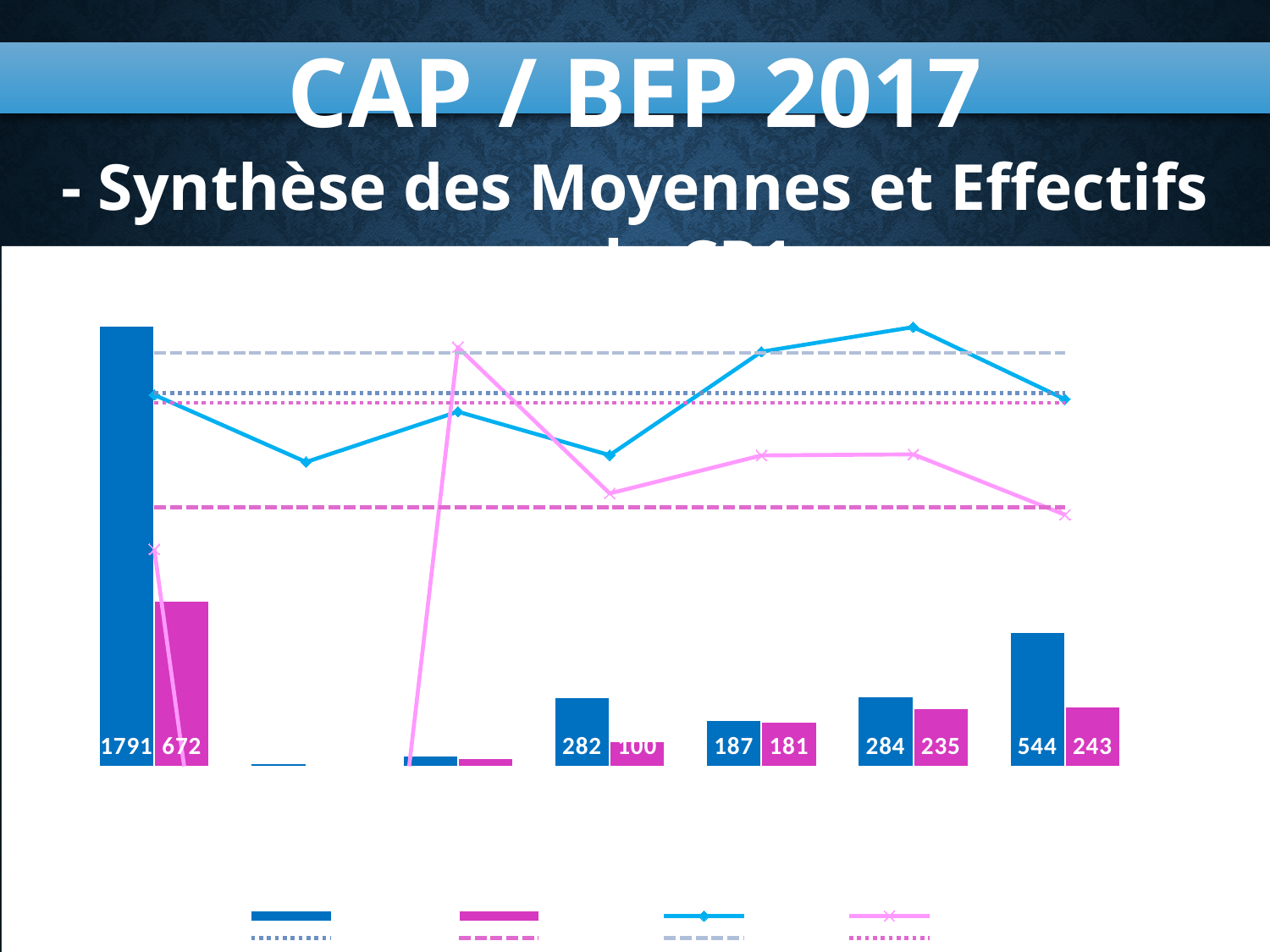
In the group with bars labelled 187 and 181, which bar is larger, the blue or the magenta one? The blue bar (187) What is the difference between the blue bar labelled 284 and the magenta bar labelled 235 in the same group? 49 What is the difference between the blue bar (544) and the magenta bar (243) in the rightmost group? 301 Which group of bars has the tallest blue bar? The leftmost group (1791) What is the value of the blue bar in the rightmost group of bars? 544 How many groups of bars are plotted along the x axis? 7 How many lines with markers are plotted on the chart (excluding the dashed reference lines)? 2 What kind of chart is shown on the slide? A combined bar and line chart What is the value of the magenta bar in the leftmost group of bars? 672 What is the difference between the blue bar labelled 282 and the magenta bar labelled 100 in the same group? 182 What is the value of the blue bar in the leftmost group of bars? 1791 What is the value of the magenta bar in the rightmost group of bars? 243